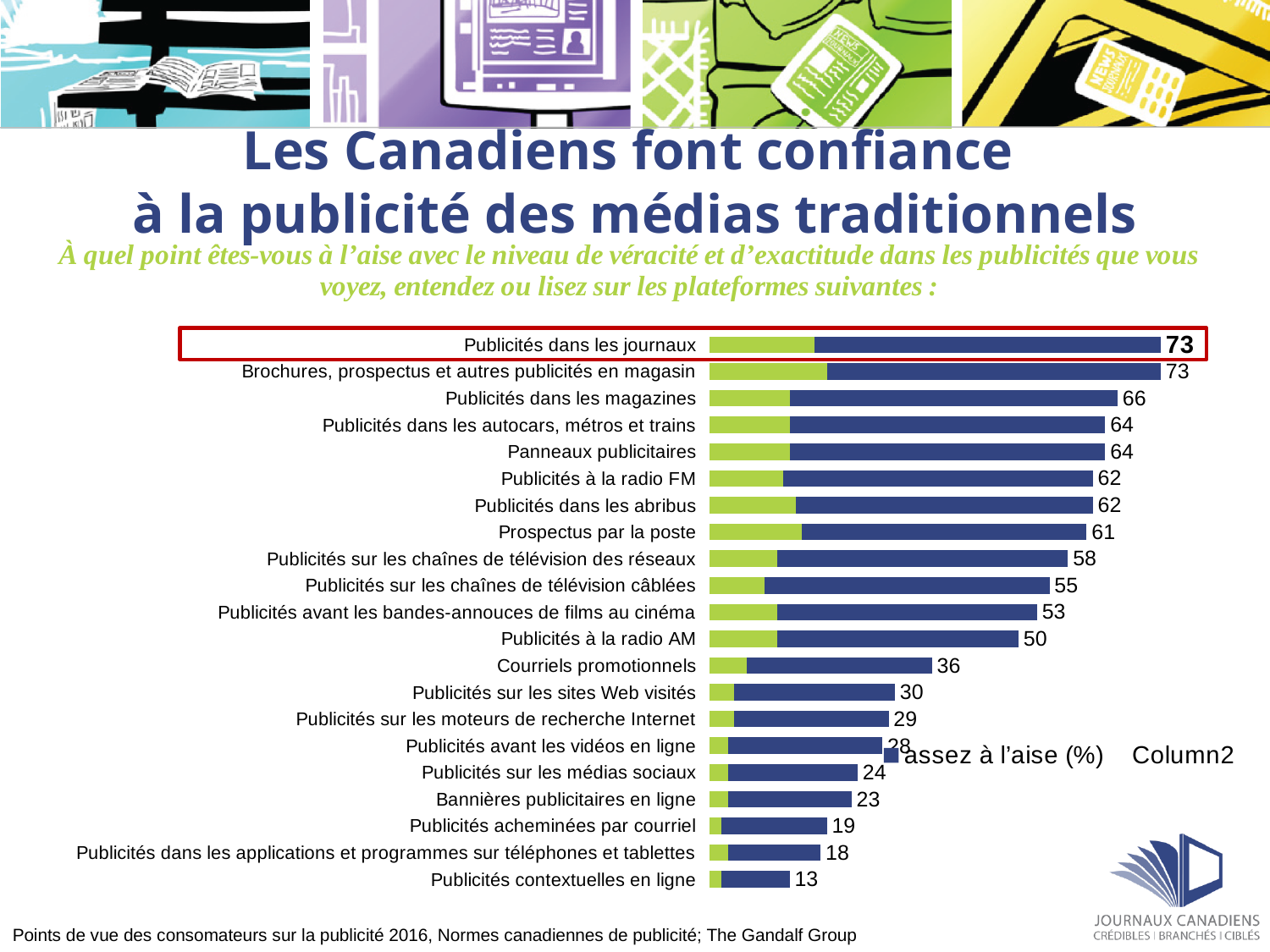
Which category has the lowest value on the chart? Publicités contextuelles en ligne How many series does the legend list? 2 What value is shown for "Courriels promotionnels"? 36 What kind of chart is shown on the slide? Bar chart What is the difference between the values for "Publicités dans les magazines" and "Publicités sur les médias sociaux"? 42 How many categories are plotted on the chart? 21 Which has a larger value: "Publicités sur les chaînes de télévision câblées" or "Publicités sur les sites Web visités"? Publicités sur les chaînes de télévision câblées What value is shown for "Publicités à la radio AM"? 50 What value is shown for "Publicités dans les journaux"? 73 What value is shown for "Publicités acheminées par courriel"? 19 Which category is highlighted with a red box on the chart? Publicités dans les journaux What is the first legend entry on the chart? assez à l'aise (%)